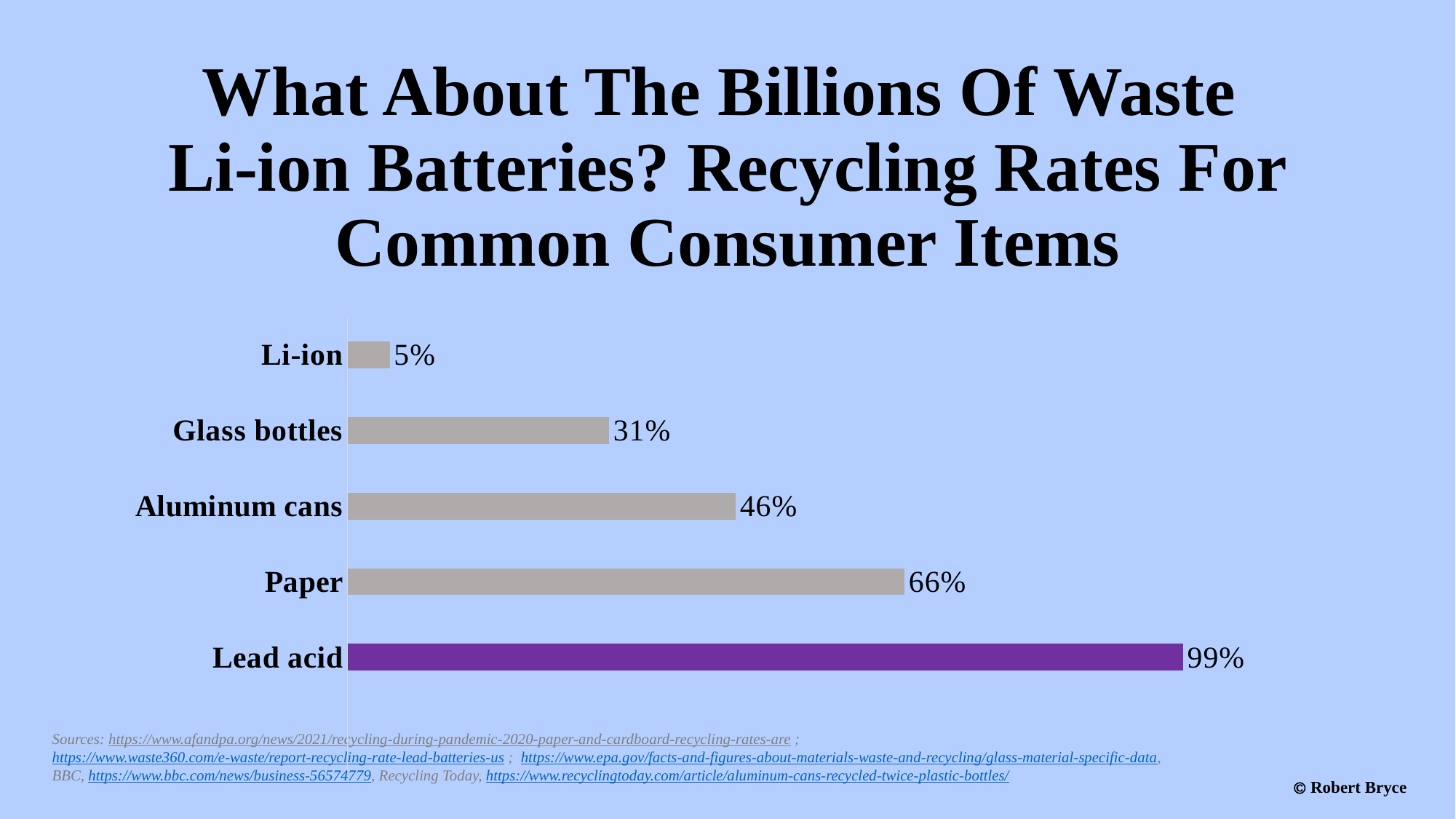
What is the recycling rate shown for Li-ion? 5% Which bar is coloured purple rather than grey? Lead acid Which item has the lowest recycling rate? Li-ion What kind of chart is shown on the slide? Bar chart What is the recycling rate shown for Aluminum cans? 46% Which item has the highest recycling rate? Lead acid What is the recycling rate shown for Paper? 66% What is the difference between the recycling rates of Paper and Aluminum cans? 20% Which has a higher recycling rate, Glass bottles or Aluminum cans? Aluminum cans What is the difference between the recycling rates of Lead acid and Li-ion? 94% How many items are shown in the chart? 5 What is the recycling rate shown for Glass bottles? 31%